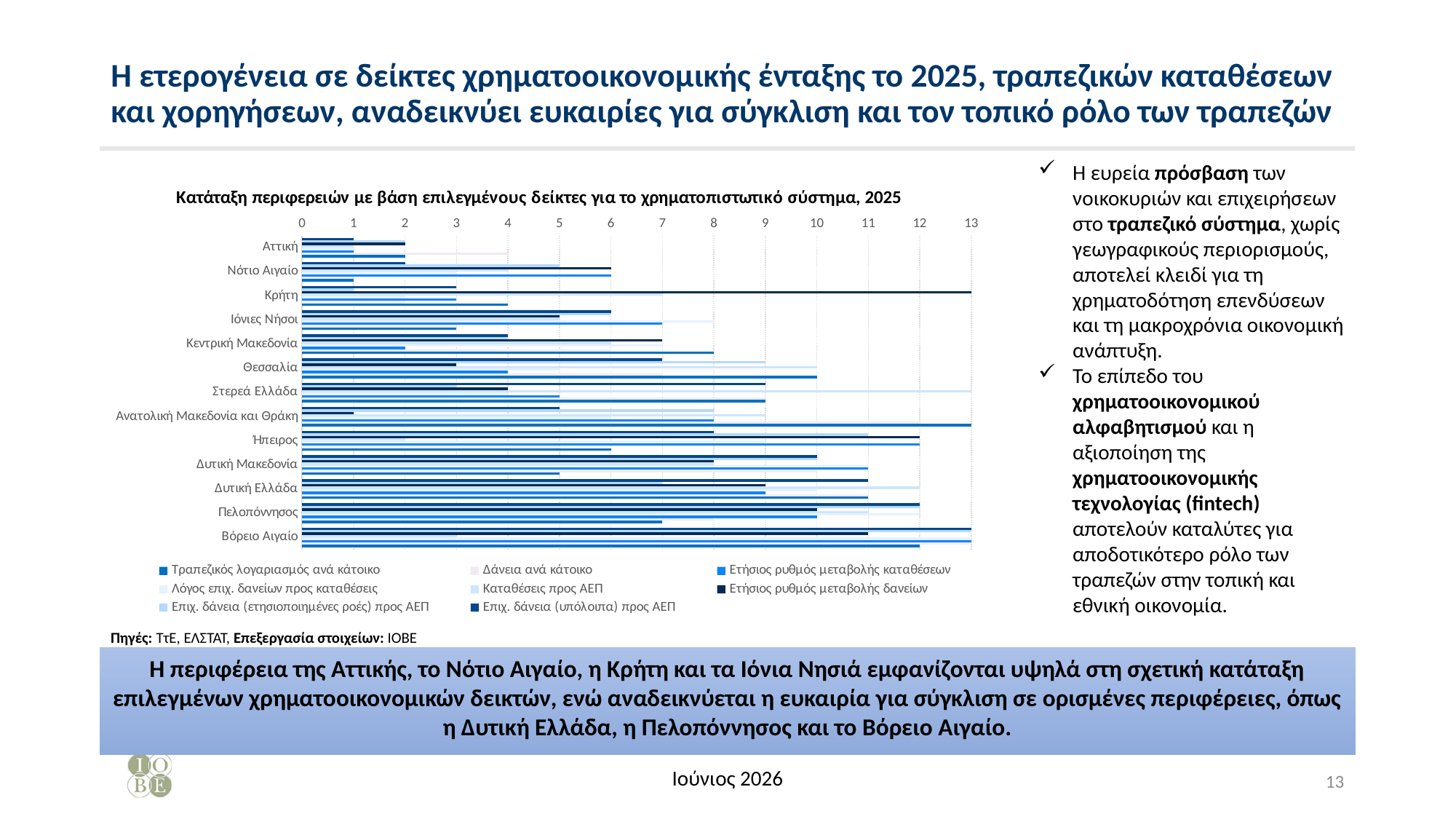
How many series does the chart legend list? 8 Is the longest bar for Ήπειρος greater or less than 10? greater Is the longest bar for Βόρειο Αιγαίο greater or less than 12? greater How many regions are listed on the vertical axis of the chart? 13 Is the longest bar for Νότιο Αιγαίο greater or less than 7? less Which region is listed first (at the top) on the chart's vertical axis? Αττική Which region has the longer longest bar, Αττική or Βόρειο Αιγαίο? Βόρειο Αιγαίο What is the title of the chart? Κατάταξη περιφερειών με βάση επιλεγμένους δείκτες για το χρηματοπιστωτικό σύστημα, 2025 What kind of chart is shown on the slide? bar chart What is the highest value shown on the horizontal axis of the chart? 13